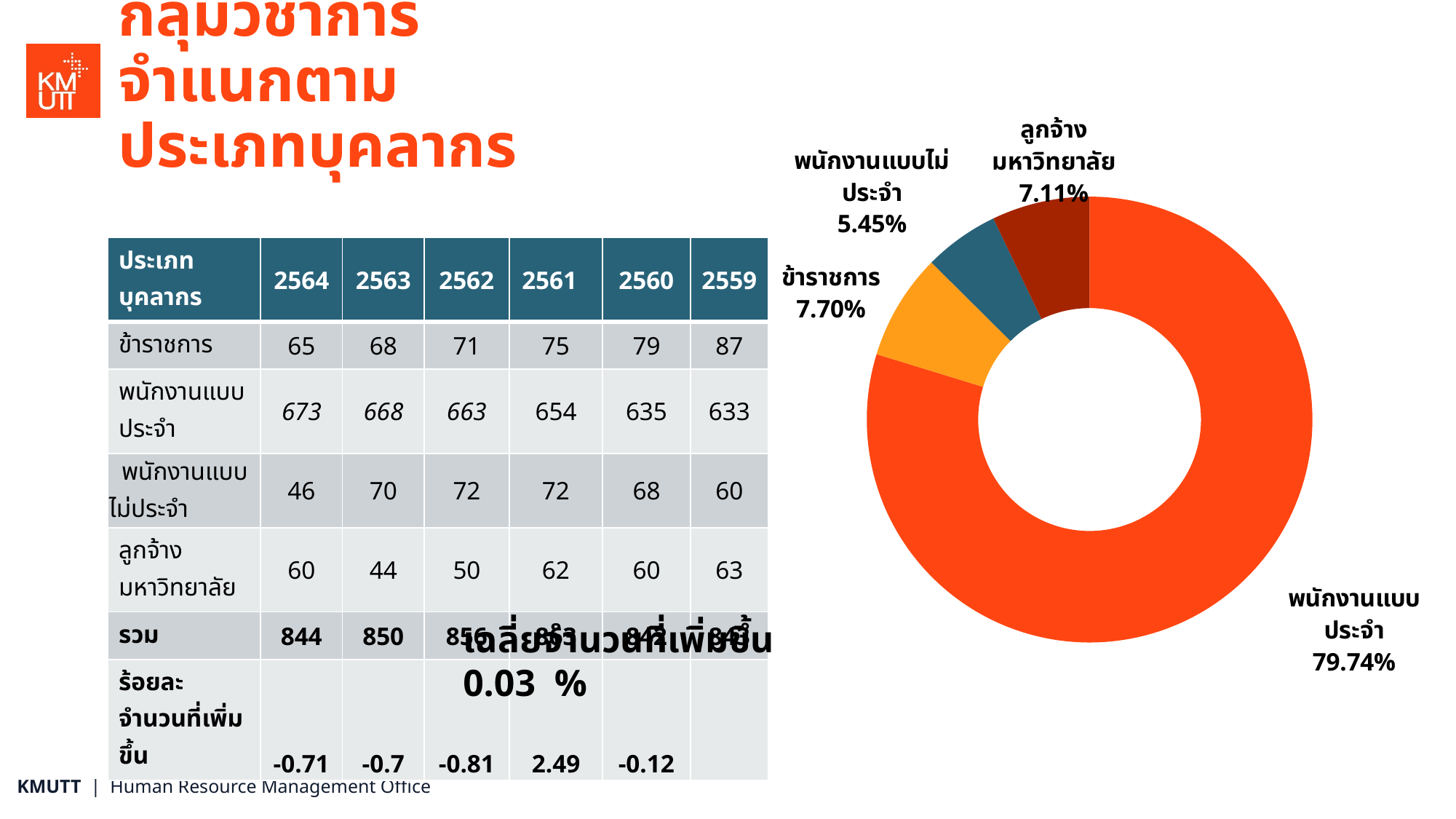
What share of the donut chart does พนักงานแบบประจำ represent? 79.74% What percentage is shown for ข้าราชการ in the donut chart? 7.70% Is the share for พนักงานแบบไม่ประจำ greater or less than the share for ลูกจ้างมหาวิทยาลัย? less What colour is the largest slice of the donut chart? Orange-red What percentage is shown for พนักงานแบบไม่ประจำ in the donut chart? 5.45% What is the difference in percentage points between the ข้าราชการ slice and the ลูกจ้างมหาวิทยาลัย slice? 0.59% What kind of chart is shown on the right of the slide? Donut (pie) chart How many categories are shown in the donut chart? 4 Which slice is larger in the donut chart, ข้าราชการ or ลูกจ้างมหาวิทยาลัย? ข้าราชการ What percentage is shown for ลูกจ้างมหาวิทยาลัย in the donut chart? 7.11% Which category has the largest slice in the donut chart? พนักงานแบบประจำ Which category has the smallest slice in the donut chart? พนักงานแบบไม่ประจำ